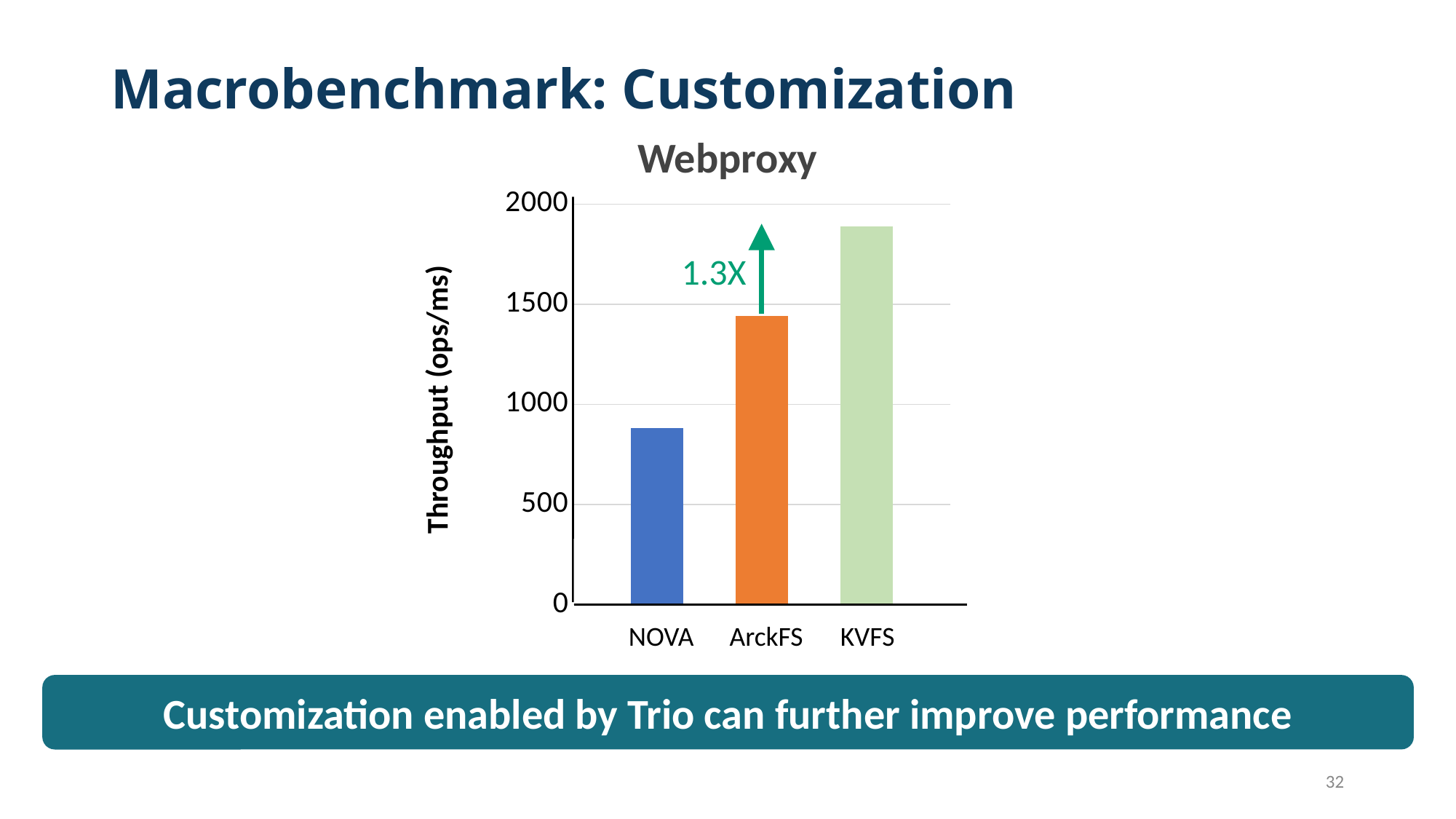
Do the throughput values rise or fall from NOVA to KVFS along the x axis? rise How many categories are plotted on the x axis? 3 What is the label on the y axis of the chart? Throughput (ops/ms) Is the value for KVFS greater or less than 1500? greater Which category has the highest throughput? KVFS Which has a higher throughput, ArckFS or KVFS? KVFS What kind of chart is shown on the slide? bar chart Is the value for NOVA greater or less than 500? greater Which category has the lowest throughput? NOVA Is the value for NOVA greater or less than 1000? less Which has a higher throughput, NOVA or ArckFS? ArckFS What is the title of the chart? Webproxy